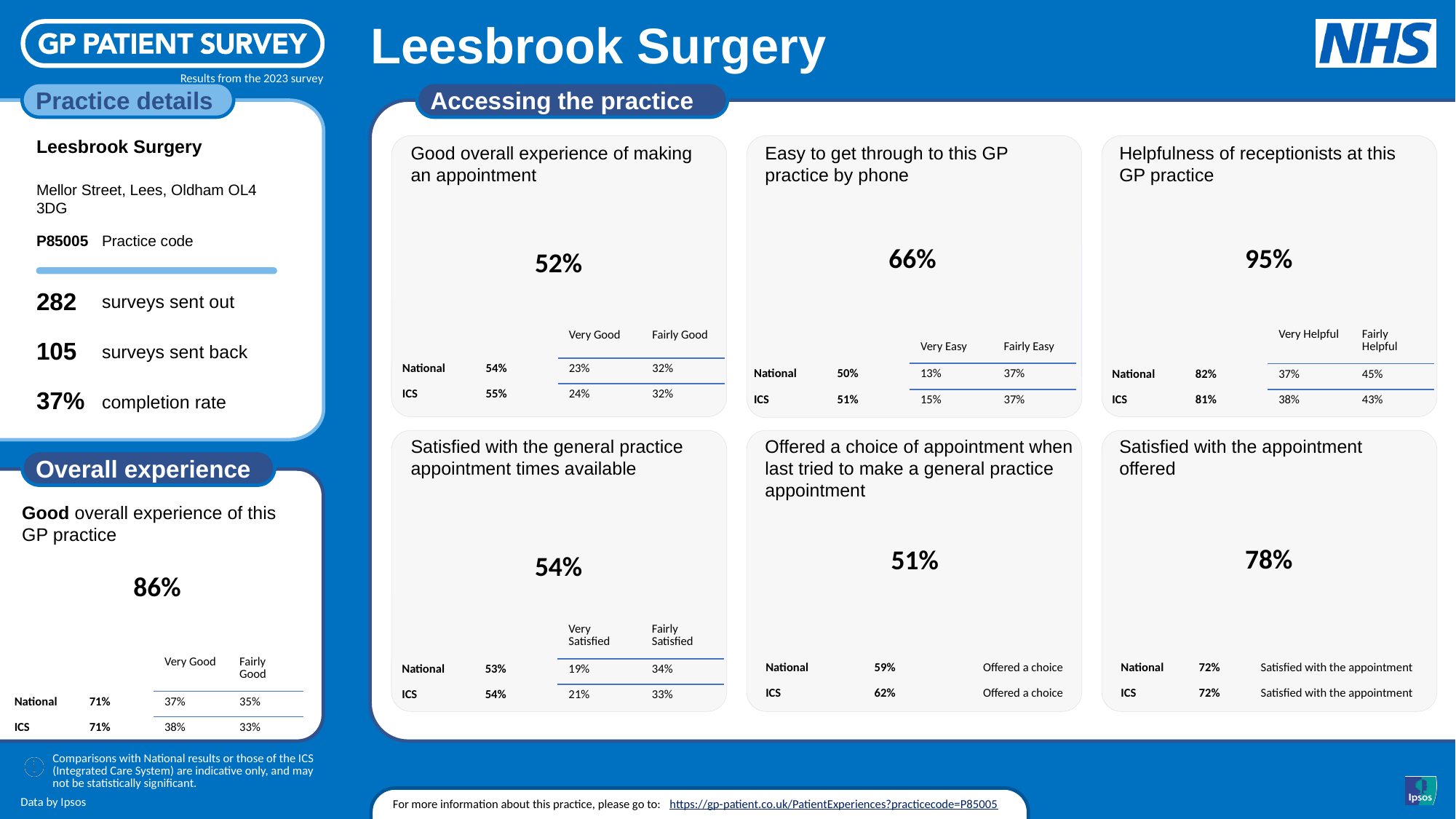
Across the six 'Accessing the practice' panels, which measure has the lowest practice percentage? Offered a choice of appointment when last tried to make a general practice appointment In the 'Satisfied with the appointment offered' panel, what is the difference between the practice's 78% and the ICS 72%? 6 percentage points In the 'Good overall experience of making an appointment' panel, what is the practice's headline percentage? 52% In the 'Helpfulness of receptionists at this GP practice' panel, what is the difference between the practice's 95% and the National 82%? 13 percentage points In the 'Helpfulness of receptionists at this GP practice' panel, what is the ICS value? 81% Across the six 'Accessing the practice' panels, which measure has the highest practice percentage? Helpfulness of receptionists at this GP practice In the 'Satisfied with the general practice appointment times available' panel, what is the National 'Very Satisfied' value? 19% How many measure panels are shown under the 'Accessing the practice' heading? 6 In the 'Overall experience' panel, what is the practice's percentage for good overall experience of this GP practice? 86% In the 'Offered a choice of appointment' panel, which is larger: the National value or the ICS value? ICS In the 'Easy to get through to this GP practice by phone' panel, what is the National value? 50% In the 'Overall experience' panel, what is the ICS 'Very Good' value? 38%